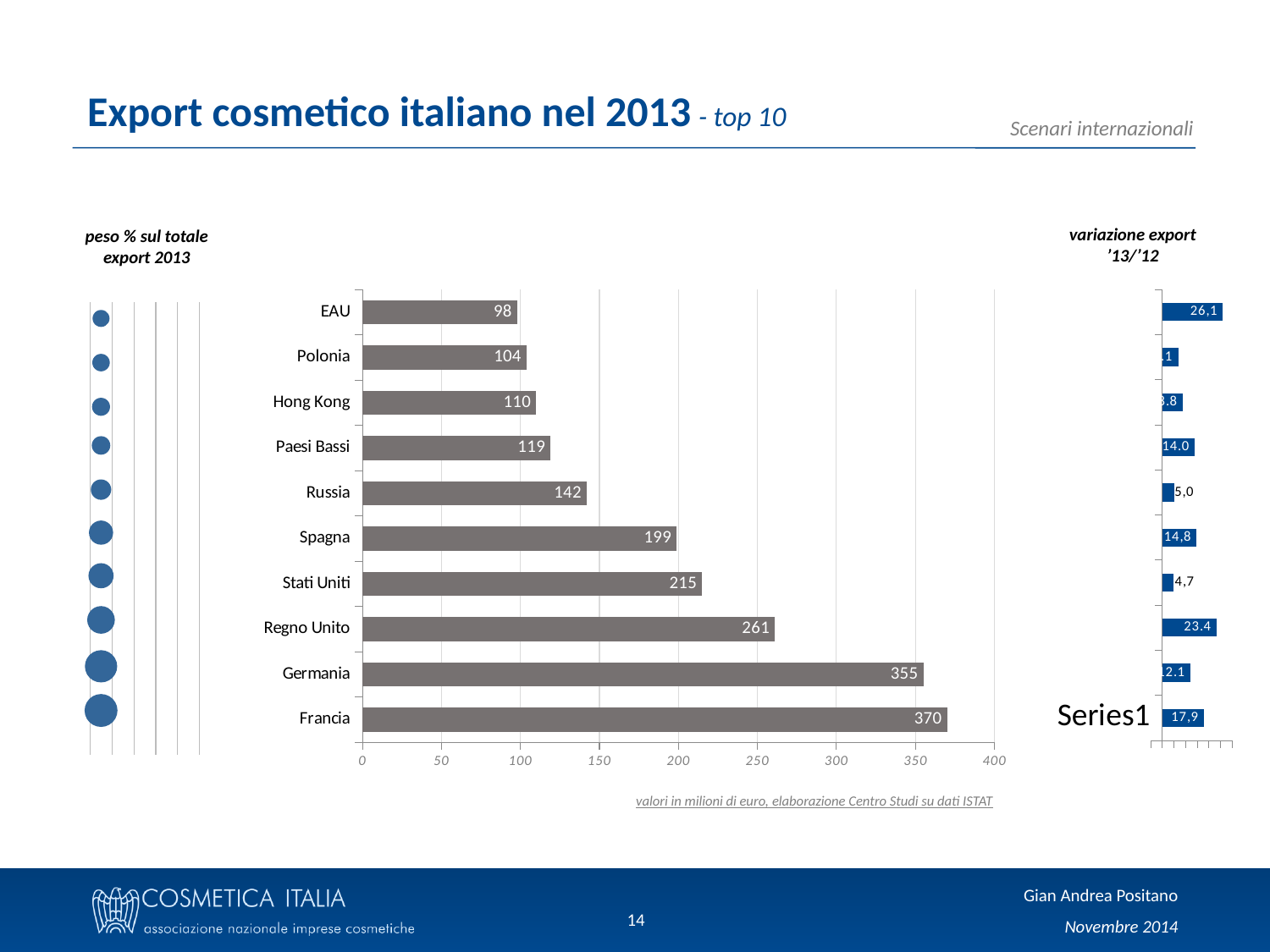
In the main bar chart of export values, which country has the lowest value? EAU In the main bar chart of export values, which is larger, Spagna or Russia? Spagna In the main bar chart of export values, what is the value for Francia? 370 In the main bar chart of export values, what is the value for Hong Kong? 110 In the main bar chart of export values, what is the value for Regno Unito? 261 In the 'variazione export '13/'12' chart on the right, what is the value for Regno Unito? 23.4 In the main bar chart of export values, which country has the highest value? Francia In the main bar chart of export values, is the value for Germania greater or less than 300? greater How many countries are shown in the main bar chart of export values? 10 What kind of chart is the main chart showing export values by country? bar chart In the 'variazione export '13/'12' chart on the right, what is the value for EAU? 26,1 In the main bar chart of export values, what is the difference between Germania and Stati Uniti? 140